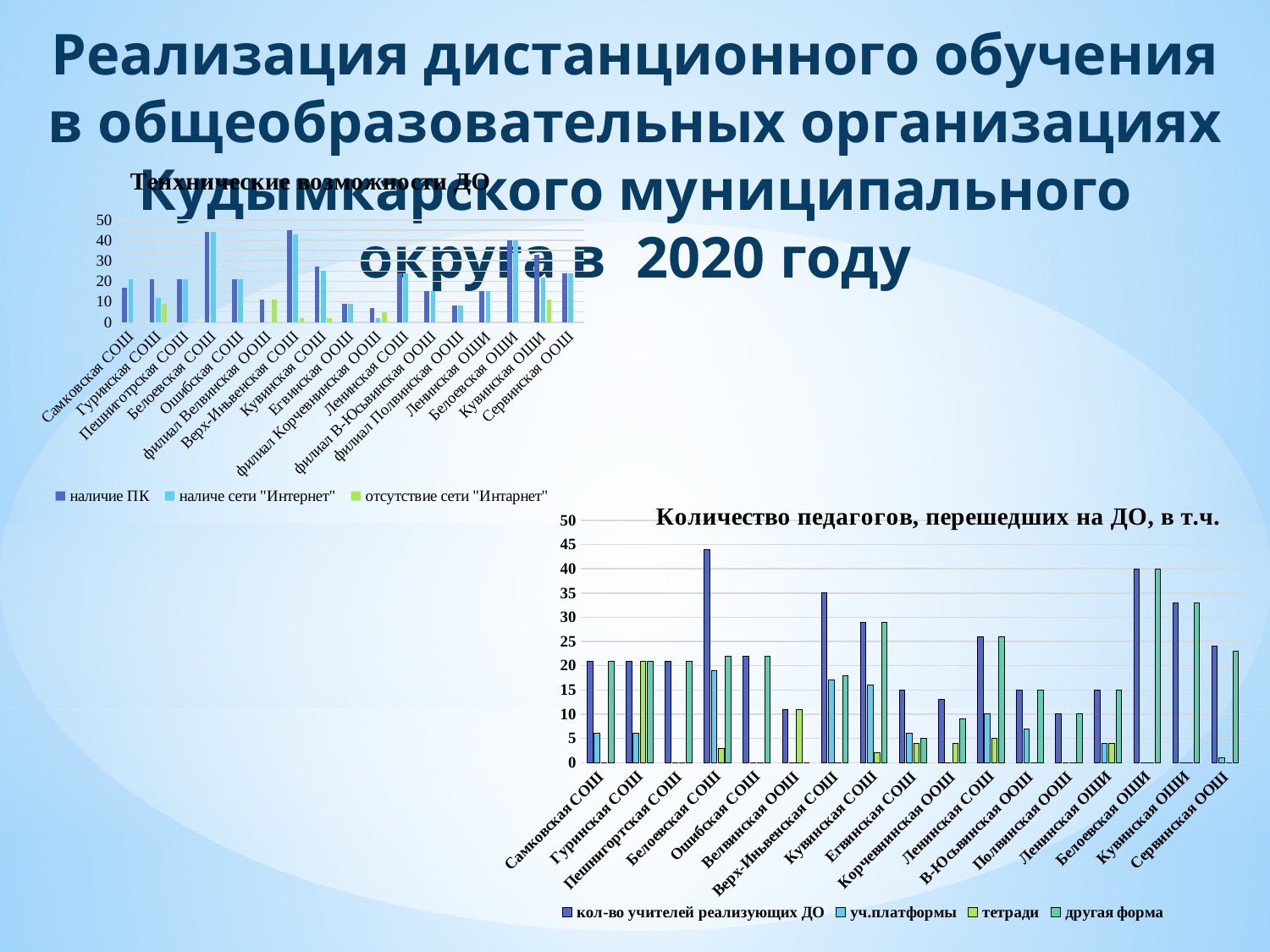
In the chart "Количество педагогов, перешедших на ДО, в т.ч.", is the value of "уч.платформы" for Самковская СОШ greater or less than 10? less What kind of chart is the chart titled "Количество педагогов, перешедших на ДО, в т.ч."? bar chart In the chart "Количество педагогов, перешедших на ДО, в т.ч.", is the value of "кол-во учителей реализующих ДО" for Белоевская СОШ greater or less than 40? greater What is the last legend entry of the chart "Количество педагогов, перешедших на ДО, в т.ч."? другая форма In the chart "Количество педагогов, перешедших на ДО, в т.ч.", is the value of "кол-во учителей реализующих ДО" for Полвинская ООШ greater or less than 15? less What kind of chart is the chart titled "Технические возможности ДО"? bar chart In the chart "Количество педагогов, перешедших на ДО, в т.ч.", which is larger for "кол-во учителей реализующих ДО": Белоевская ОШИ or Кувинская ОШИ? Белоевская ОШИ In the chart "Количество педагогов, перешедших на ДО, в т.ч.", which school has the highest value for "кол-во учителей реализующих ДО"? Белоевская СОШ How many series does the legend of the chart "Количество педагогов, перешедших на ДО, в т.ч." list? 4 How many series does the legend of the chart "Технические возможности ДО" list? 3 How many schools (categories) are shown on the x axis of the chart "Количество педагогов, перешедших на ДО, в т.ч."? 17